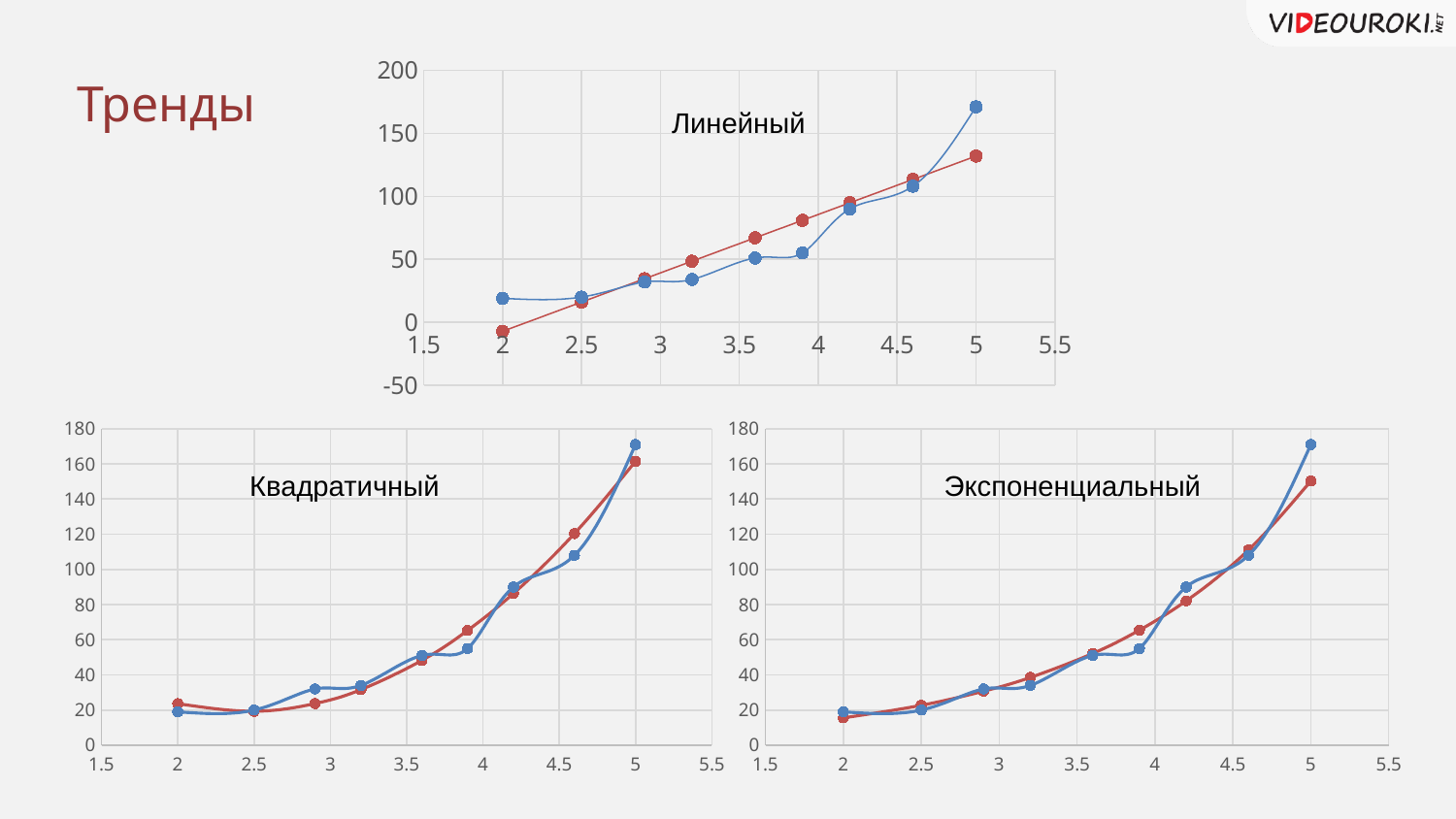
In the chart titled "Линейный", do the values of the red series rise or fall as x increases? rise In the chart titled "Экспоненциальный", is the value of the blue series at x = 4.2 greater or less than 80? greater In the chart titled "Линейный", which series has the larger value at x = 5, the blue or the red? blue What kind of chart is the chart titled "Линейный"? line chart In the chart titled "Экспоненциальный", at which x value does the blue series reach its highest value? 5 In the chart titled "Линейный", is the value of the red series at x = 2 greater or less than 0? less How many charts are shown on the slide? 3 In the chart titled "Квадратичный", how many data points does the blue series have? 9 In the chart titled "Линейный", is the value of the blue series at x = 5 greater or less than 150? greater In the chart titled "Экспоненциальный", do the values of the blue series generally rise or fall along the x axis? rise What is the title of the chart at the bottom right of the slide? Экспоненциальный